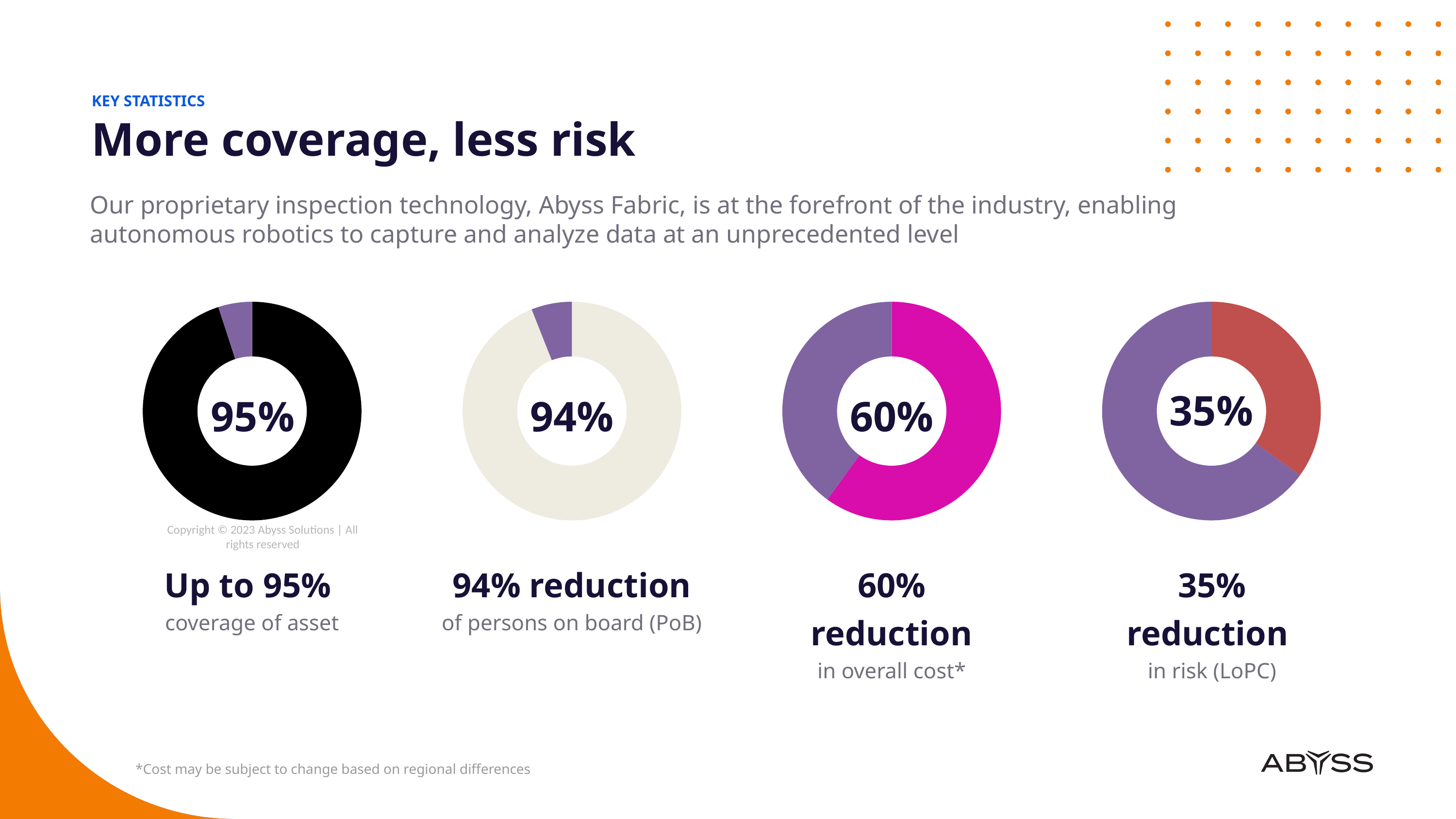
What colour is the large filled segment of the third donut chart (60% reduction in overall cost)? Magenta What value is shown in the centre of the third donut chart (reduction in overall cost)? 60% Which is larger: the reduction in overall cost or the reduction in risk (LoPC)? Reduction in overall cost How many donut charts are shown on the slide? 4 What is the difference between the reduction of persons on board and the reduction in overall cost? 34% What value is shown in the centre of the rightmost donut chart (reduction in risk)? 35% What value is shown in the centre of the second donut chart (reduction of persons on board)? 94% What kind of chart is used for each of the four key statistics on the slide? Donut chart Which of the four donut charts shows the highest percentage? Coverage of asset (95%) What value is shown in the centre of the leftmost donut chart (coverage of asset)? 95% What is the difference between the coverage of asset percentage and the reduction in risk percentage? 60% Which of the four donut charts shows the lowest percentage? Reduction in risk (LoPC) (35%)